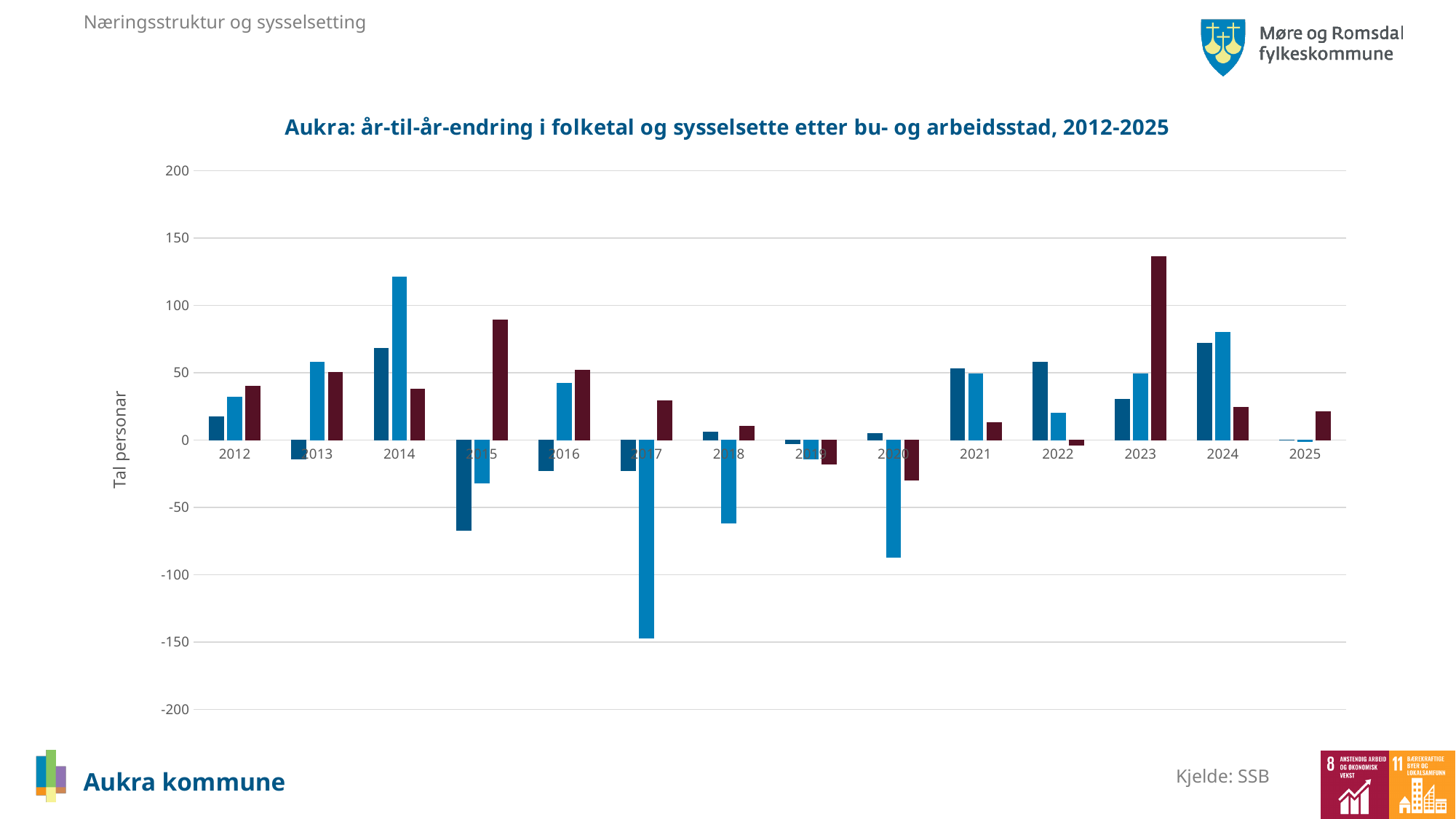
Is the value of the dark red bar for 2023 greater or less than 100? greater How many years are shown along the x axis of the chart? 14 In which year does the chart show the highest bar? 2023 Is the value of the light blue bar for 2020 greater or less than -50? less Is the value of the dark red bar for 2015 greater or less than 50? greater In which year does the chart show the lowest (most negative) bar? 2017 What kind of chart is shown on the slide? bar chart How many bars are plotted for each year in the chart? 3 What is the title of the chart? Aukra: år-til-år-endring i folketal og sysselsette etter bu- og arbeidsstad, 2012-2025 What is the label on the vertical axis of the chart? Tal personar